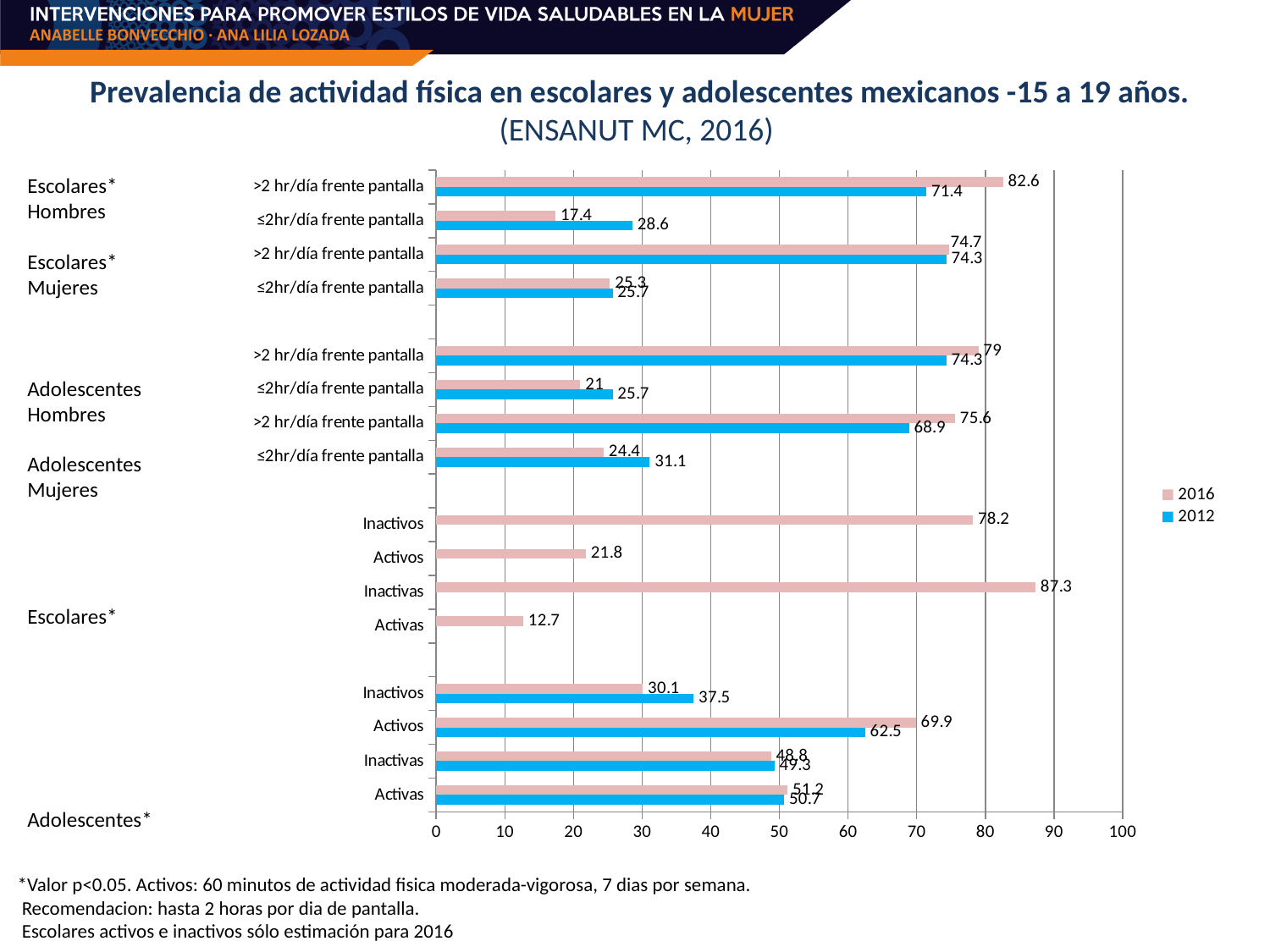
What is the 2016 value for Escolares 'Inactivas'? 87.3 What is the 2012 value for Adolescentes 'Activos'? 62.5 Which category has the highest 2016 value in the chart? Inactivas (Escolares) Which category has the lowest 2016 value in the chart? Activas (Escolares) What is the 2016 value for Escolares Hombres '>2 hr/día frente pantalla'? 82.6 What is the 2012 value for Escolares Hombres '≤2hr/día frente pantalla'? 28.6 Which legend entry is shown in blue? 2012 Which is larger for Adolescentes 'Inactivos': the 2016 value or the 2012 value? 2012 What is the difference between the 2016 and 2012 values for Adolescentes Mujeres '>2 hr/día frente pantalla'? 6.7 How many series does the legend list? 2 What type of chart is shown on the slide? bar chart What is the difference between the 2016 values for Escolares 'Inactivos' and 'Activos'? 56.4